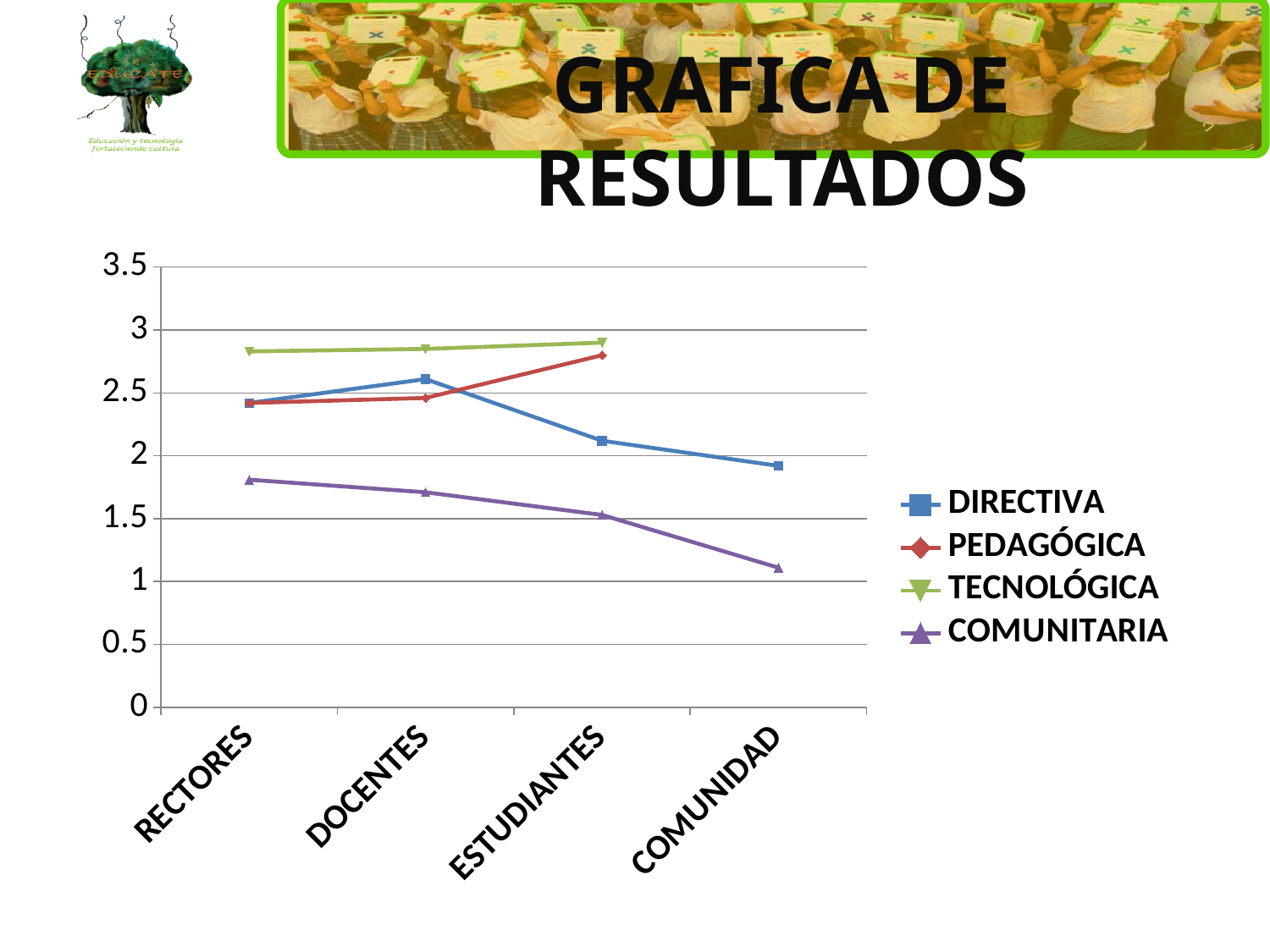
Do the values of the COMUNITARIA series rise or fall from RECTORES to COMUNIDAD? fall Which series has the highest value at RECTORES? TECNOLÓGICA Is the value for COMUNITARIA at COMUNIDAD greater or less than 1.5? less At ESTUDIANTES, which is larger: the value for DIRECTIVA or the value for COMUNITARIA? DIRECTIVA How many categories are shown on the x axis? 4 Which series is drawn in purple in the legend? COMUNITARIA How many series does the legend list? 4 Is the value for DIRECTIVA at DOCENTES greater or less than 2.5? greater Is the value for COMUNITARIA at RECTORES greater or less than 2? less What kind of chart is shown on the slide? line chart Which series has the lowest value at COMUNIDAD? COMUNITARIA